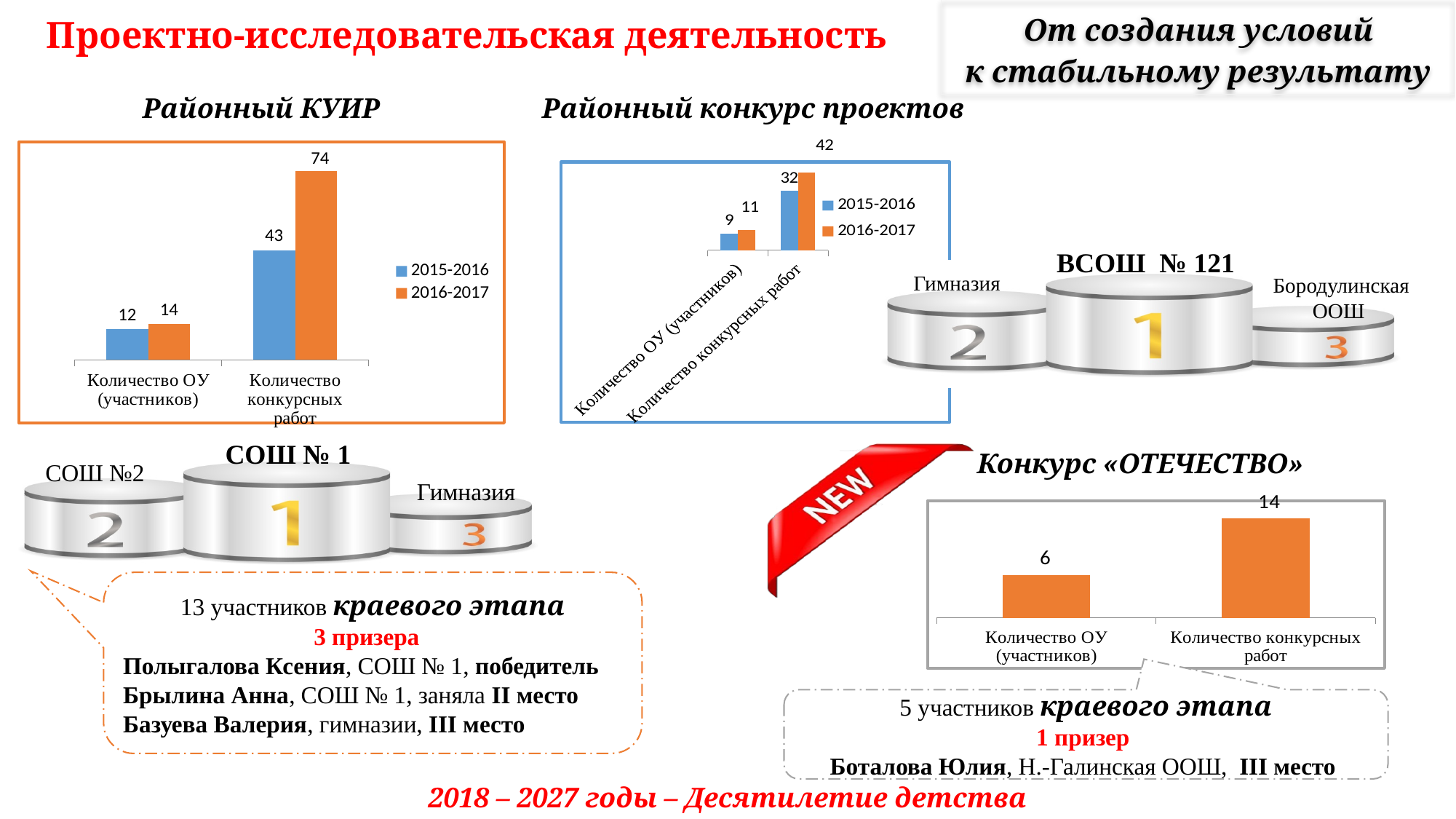
How many categories are shown in the 'Конкурс «ОТЕЧЕСТВО»' chart? 2 What type of chart is the 'Районный КУИР' chart? bar chart In the 'Районный КУИР' chart, what is the value for 'Количество ОУ (участников)' in 2015-2016? 12 How many series does the legend of the 'Районный КУИР' chart list? 2 In the 'Районный конкурс проектов' chart, what is the value for 'Количество ОУ (участников)' in 2015-2016? 9 In the 'Районный конкурс проектов' chart, which is larger for 'Количество конкурсных работ': 2015-2016 or 2016-2017? 2016-2017 In the 'Районный КУИР' chart, what is the value for 'Количество конкурсных работ' in 2016-2017? 74 In the 'Районный конкурс проектов' chart, what is the value for 'Количество конкурсных работ' in 2016-2017? 42 In the 'Конкурс «ОТЕЧЕСТВО»' chart, which category has the lowest value? Количество ОУ (участников) In the 'Районный конкурс проектов' chart, what is the difference between the 2016-2017 and 2015-2016 values for 'Количество ОУ (участников)'? 2 In the 'Районный КУИР' chart, what is the difference between the 2016-2017 and 2015-2016 values for 'Количество конкурсных работ'? 31 In the 'Конкурс «ОТЕЧЕСТВО»' chart, what is the value for 'Количество конкурсных работ'? 14